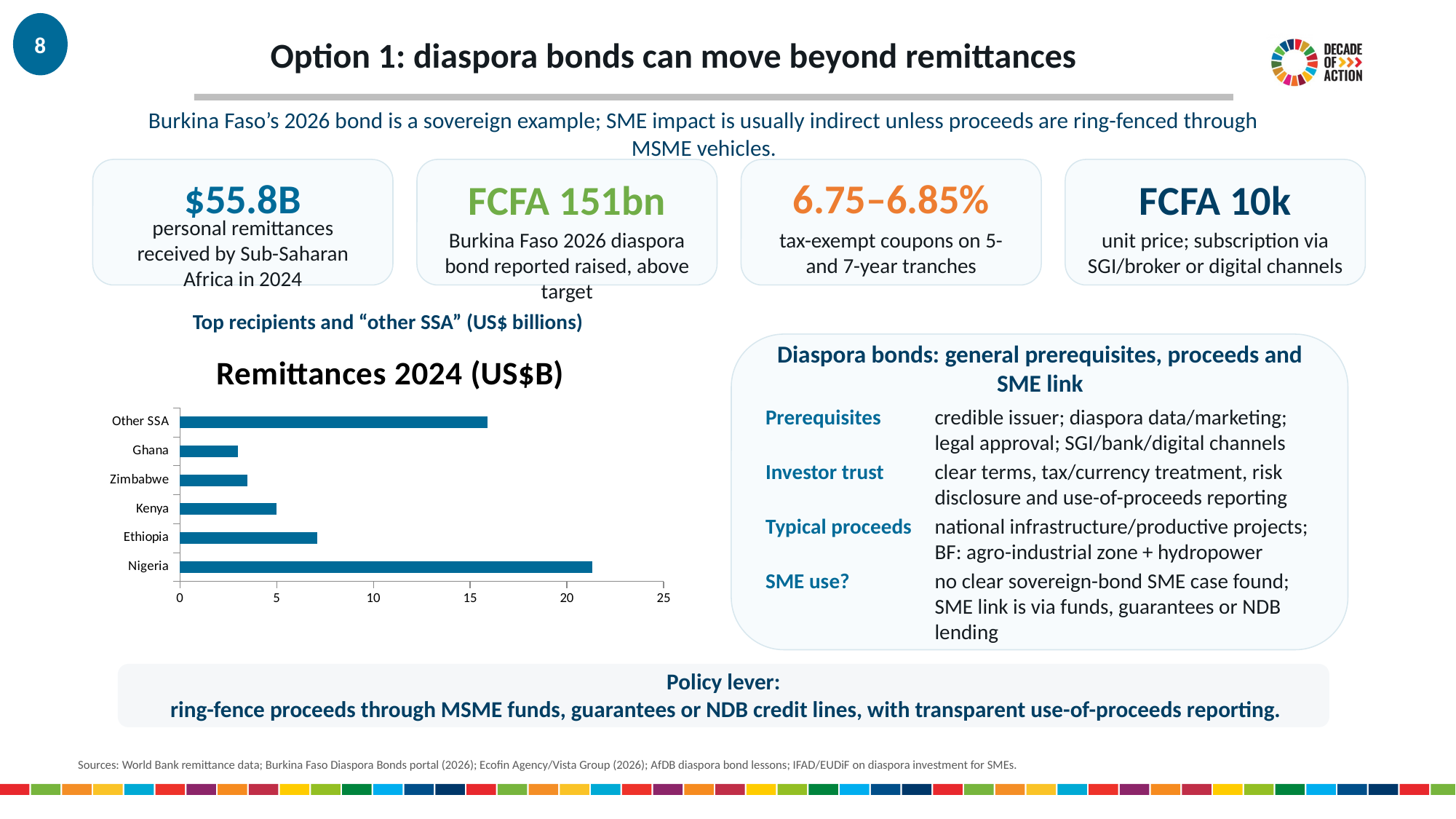
Is the value for Other SSA greater or less than 15? greater Is the value for Zimbabwe greater or less than 5? less Is the value for Ethiopia greater or less than 5? greater Which is larger, the value for Ethiopia or the value for Kenya? Ethiopia What kind of chart is shown on the slide? bar chart Which category has the highest value in the Remittances 2024 chart? Nigeria Which is larger, the value for Nigeria or the value for Other SSA? Nigeria How many categories are plotted in the Remittances 2024 chart? 6 What is the title of the chart? Remittances 2024 (US$B)